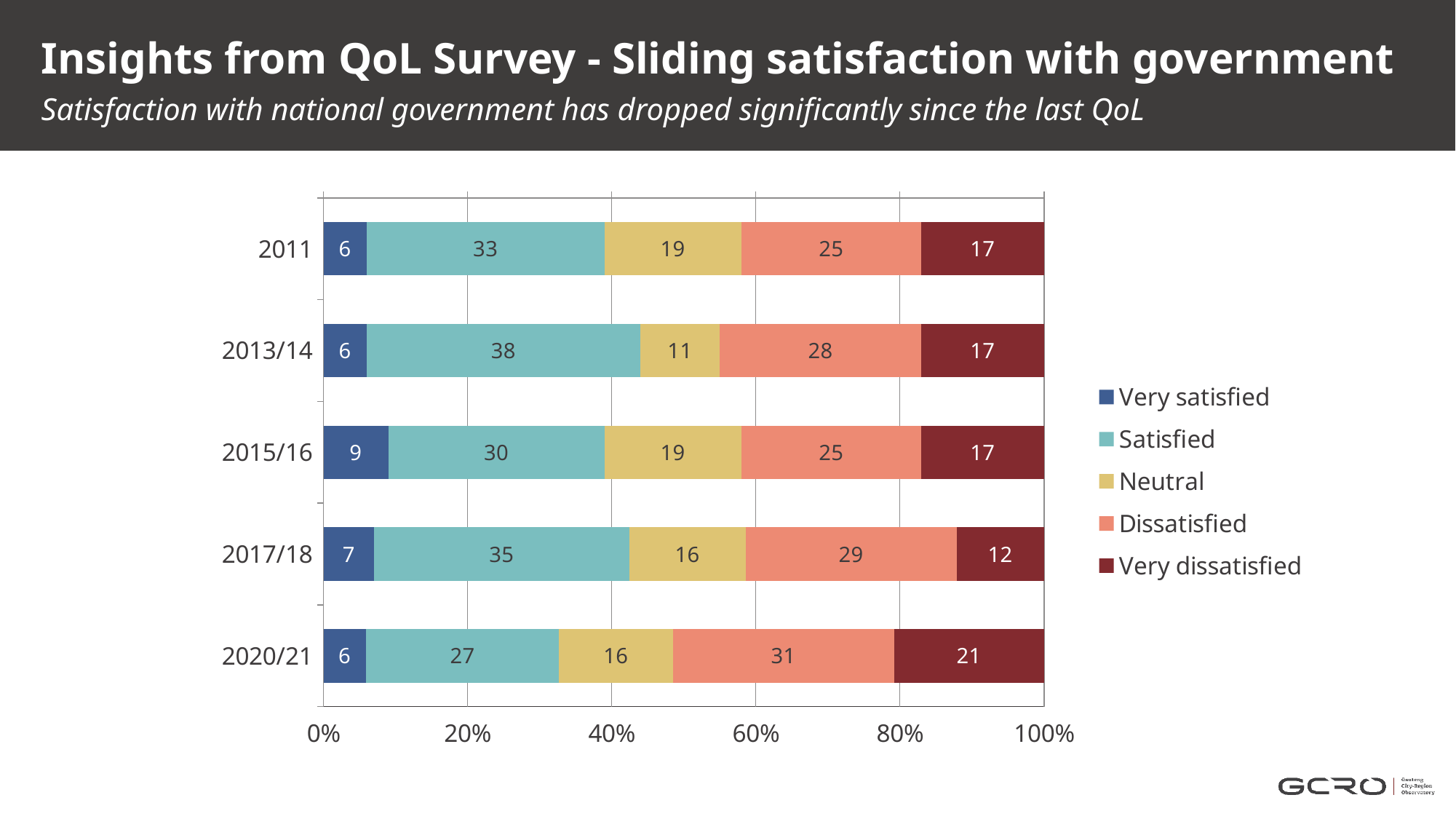
How many series does the legend list? 5 What is the value for Neutral in 2011? 19 What is the value for Very dissatisfied in 2020/21? 21 What is the difference between the Satisfied values for 2013/14 and 2020/21? 11 How many years are shown on the chart? 5 Which year has the highest value for Very satisfied? 2015/16 Which is larger, the Dissatisfied value for 2020/21 or for 2011? 2020/21 Which colour represents Neutral in the legend? Yellow Which year has the lowest value for Very dissatisfied? 2017/18 What is the value for Dissatisfied in 2017/18? 29 What kind of chart is shown on the slide? Stacked bar chart What is the value for Satisfied in 2013/14? 38